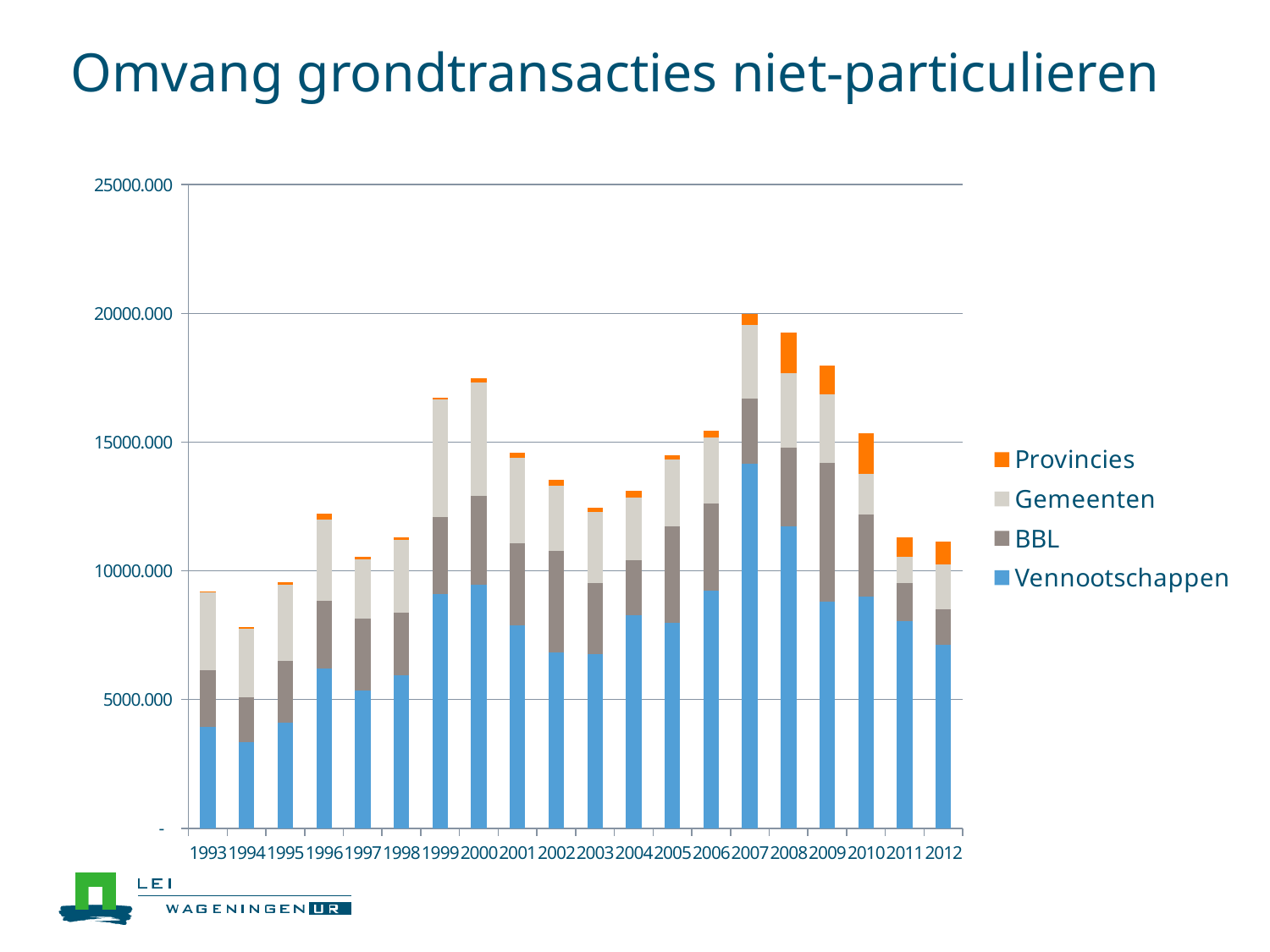
How many years are shown on the x axis of the chart? 20 What is the title of the slide? Omvang grondtransacties niet-particulieren Which year has the lowest total bar? 1994 Is the Vennootschappen value for 2007 greater or less than 10000.000? greater Which year has the highest total bar? 2007 Which year has the larger total bar, 2007 or 2012? 2007 Is the total for 1994 greater or less than 10000.000? less How many series does the legend list? 4 What kind of chart is shown on the slide? Stacked bar chart Is the Vennootschappen value for 1993 greater or less than 5000.000? less Do the total bars rise or fall from 2009 to 2011? fall